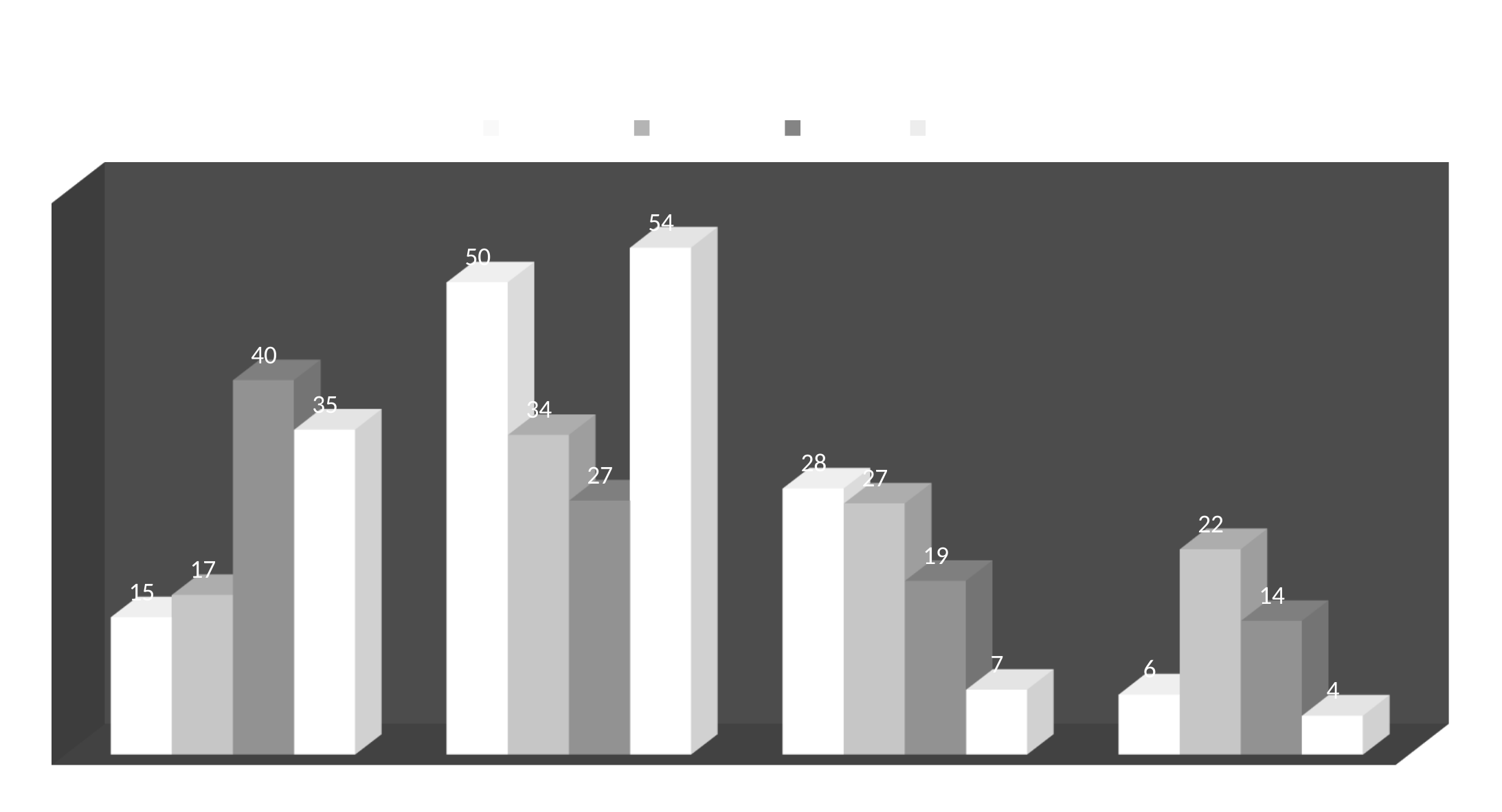
Which is larger in the first group from the left: the third bar or the fourth bar? the third bar (40) What is the value of the first (leftmost) bar in the second group from the left? 50 What is the value of the second bar in the fourth group from the left? 22 What is the difference between the fourth bar (54) and the third bar (27) in the second group from the left? 27 What is the value of the tallest bar in the first group from the left? 40 What is the difference between the first bar (15) and the second bar (17) in the first group from the left? 2 How many series does the legend list? 4 What is the value of the last (rightmost) bar in the third group from the left? 7 How many groups of bars are plotted along the x axis? 4 What is the highest value labelled on any bar in the chart? 54 What is the lowest value labelled on any bar in the chart? 4 What kind of chart is shown on the slide? bar chart